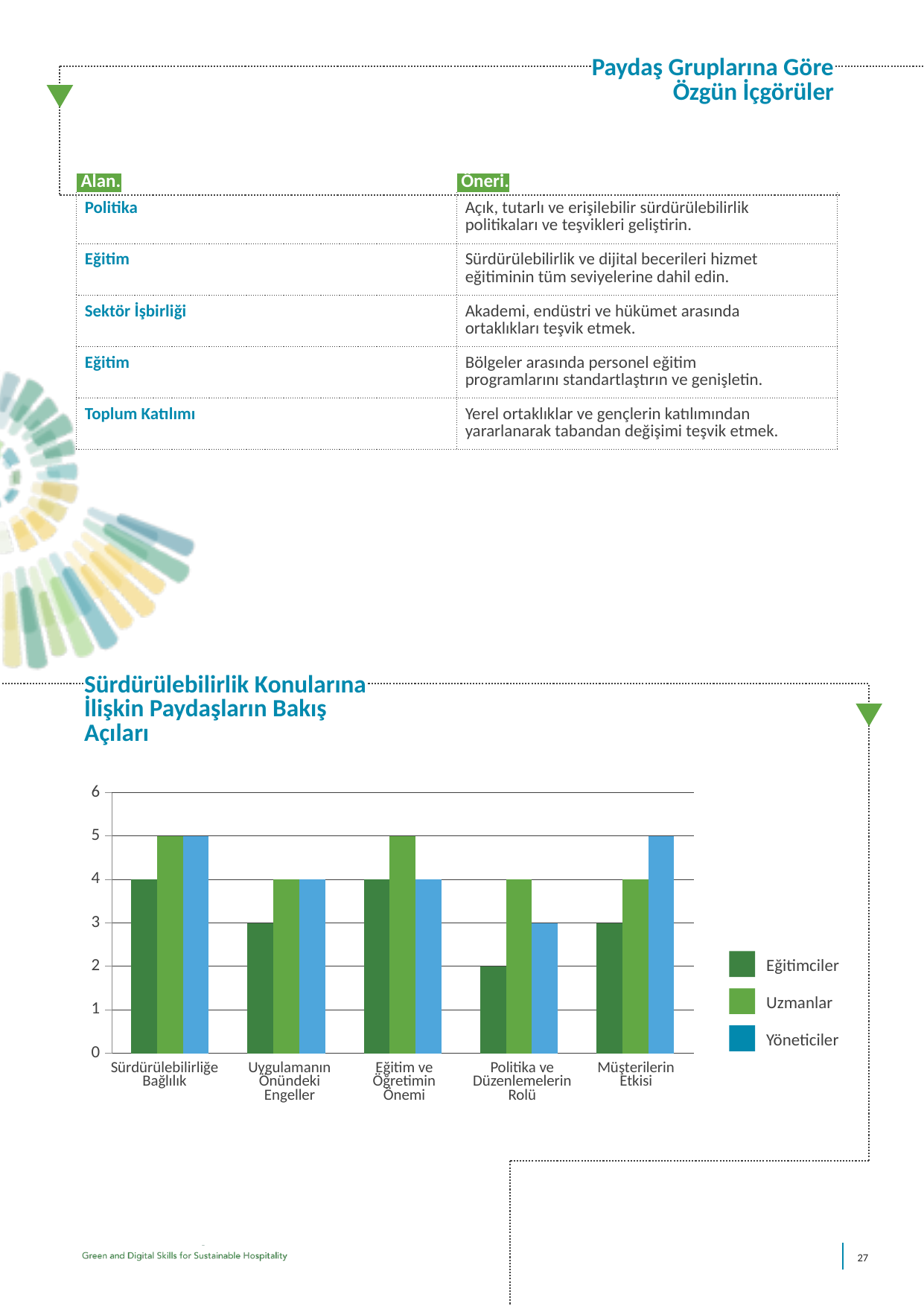
What is the difference between the Uzmanlar and Eğitimciler values in the 'Politika ve Düzenlemelerin Rolü' category? 2 Which series in the bar chart is shown in dark green? Eğitimciler What is the value for Uzmanlar in the 'Eğitim ve Öğretimin Önemi' category? 5 What kind of chart is shown under the title 'Sürdürülebilirlik Konularına İlişkin Paydaşların Bakış Açıları'? Bar chart How many categories are shown on the x axis of the bar chart? 5 In the 'Müşterilerin Etkisi' category, which series has the larger value: Eğitimciler or Yöneticiler? Yöneticiler In which category does the Eğitimciler series have its lowest value? Politika ve Düzenlemelerin Rolü What is the value for Eğitimciler in the 'Sürdürülebilirliğe Bağlılık' category? 4 What is the value for Yöneticiler in the 'Müşterilerin Etkisi' category? 5 Is the value for Yöneticiler in the 'Politika ve Düzenlemelerin Rolü' category greater or less than 4? less What is the value for Eğitimciler in the 'Politika ve Düzenlemelerin Rolü' category? 2 How many series does the legend of the bar chart list? 3